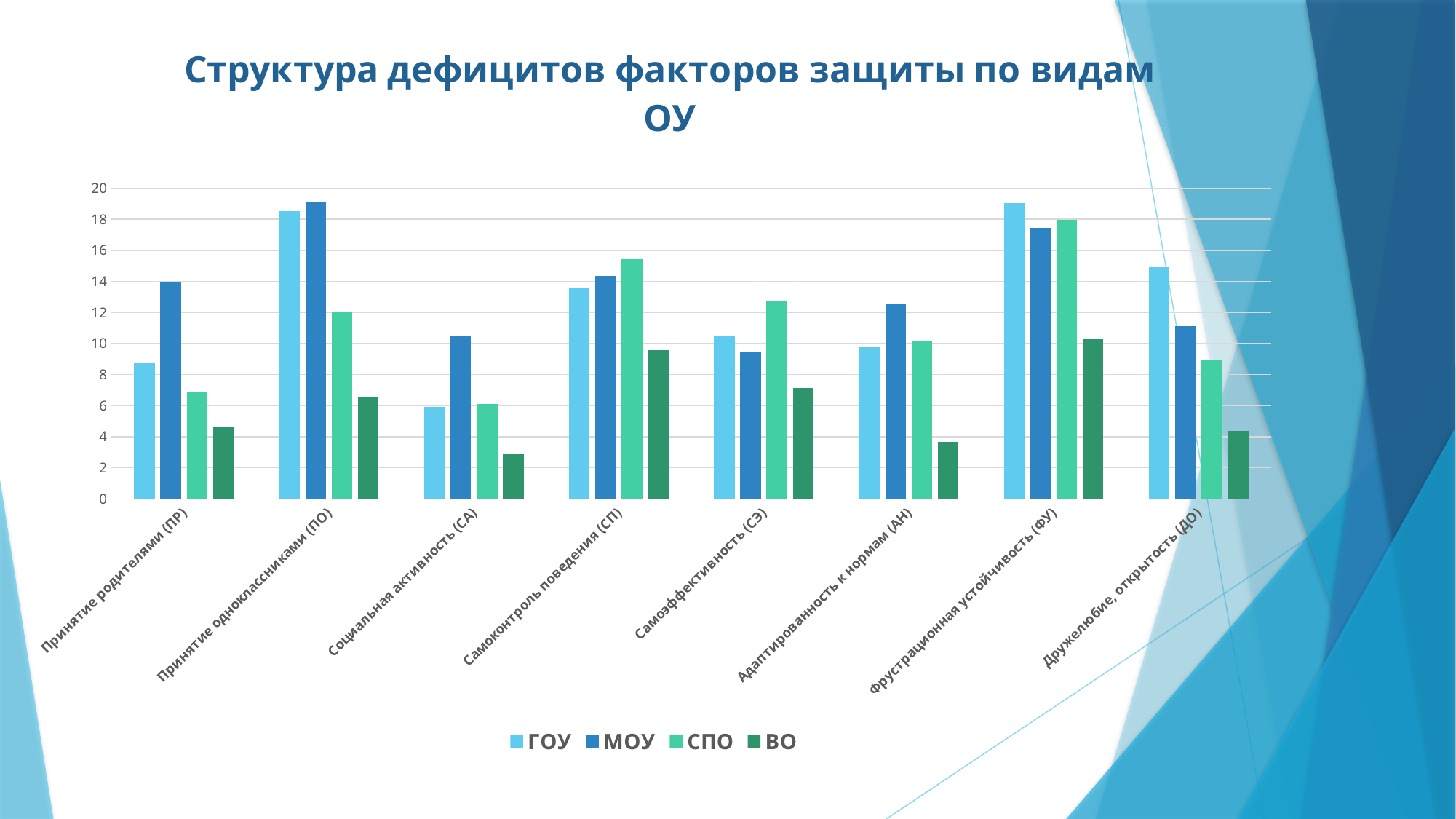
Is the value for МОУ in the category Принятие одноклассниками (ПО) greater or less than 18? greater How many series does the legend list? 4 Which category has the lowest value for the ГОУ series? Социальная активность (СА) What kind of chart is shown on the slide? bar chart What is the title of the chart? Структура дефицитов факторов защиты по видам ОУ Is the value for СПО in the category Самоконтроль поведения (СП) greater or less than 14? greater Which category has the highest value for the МОУ series? Принятие одноклассниками (ПО) In the category Дружелюбие, открытость (ДО), which is larger: ГОУ or МОУ? ГОУ How many categories are shown on the x axis of the chart? 8 Which series are listed in the legend? ГОУ, МОУ, СПО, ВО Is the value for ВО in the category Социальная активность (СА) greater or less than 4? less In the category Принятие родителями (ПР), which is larger: ГОУ or МОУ? МОУ